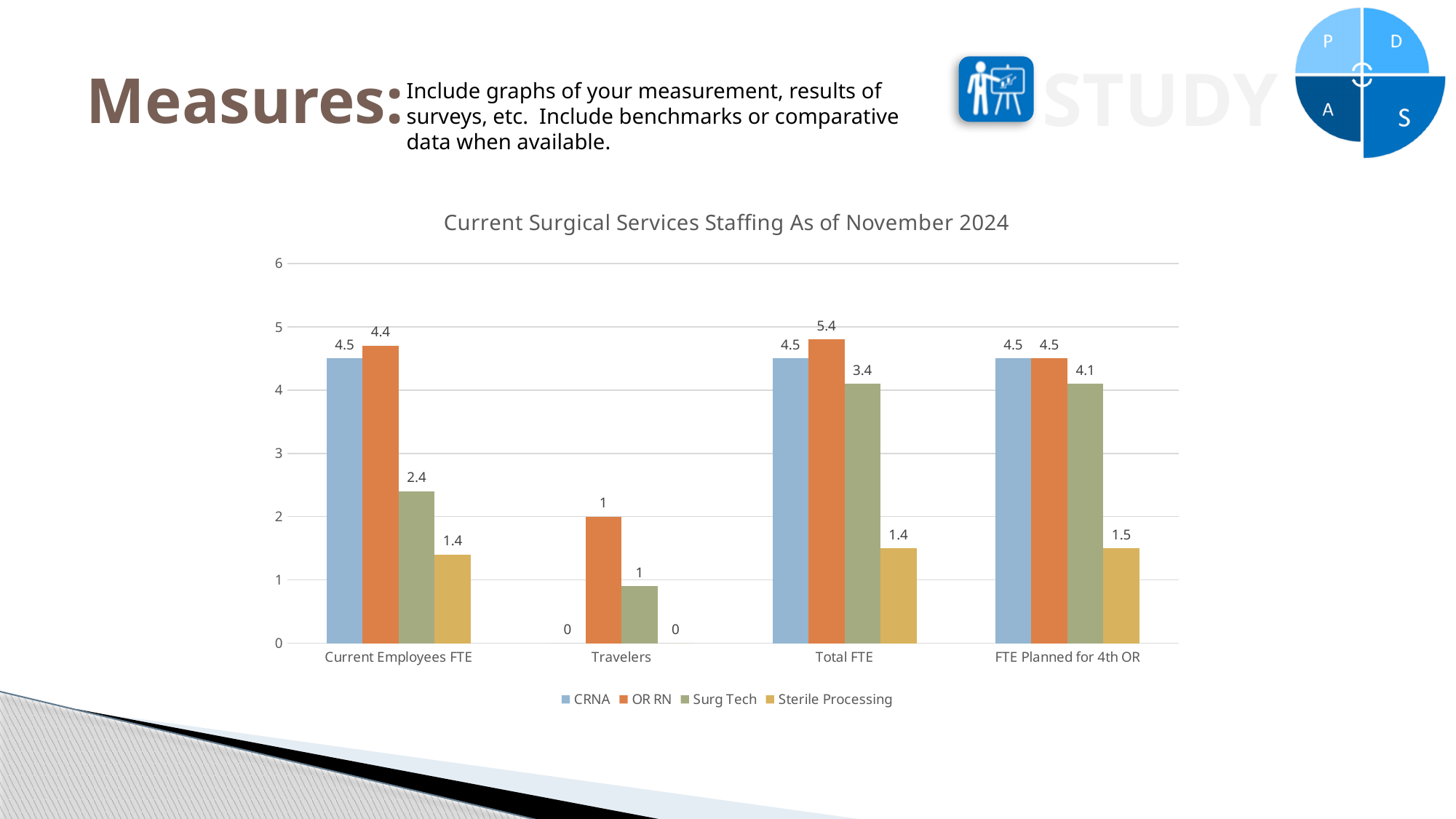
How many categories are shown on the x axis? 4 What kind of chart is shown on the slide? Bar chart What is the value for OR RN in the Total FTE category? 5.4 What is the value for Sterile Processing in the FTE Planned for 4th OR category? 1.5 What is the value for CRNA in the Travelers category? 0 What is the value for Surg Tech in the Current Employees FTE category? 2.4 Which series has the lowest value in the FTE Planned for 4th OR category? Sterile Processing What is the title of the chart? Current Surgical Services Staffing As of November 2024 Which series has the highest value in the Total FTE category? OR RN Which is larger: the Surg Tech value for Total FTE or the Surg Tech value for Current Employees FTE? Total FTE What is the difference between the OR RN and Sterile Processing values in the Total FTE category? 4 How many series does the legend list? 4